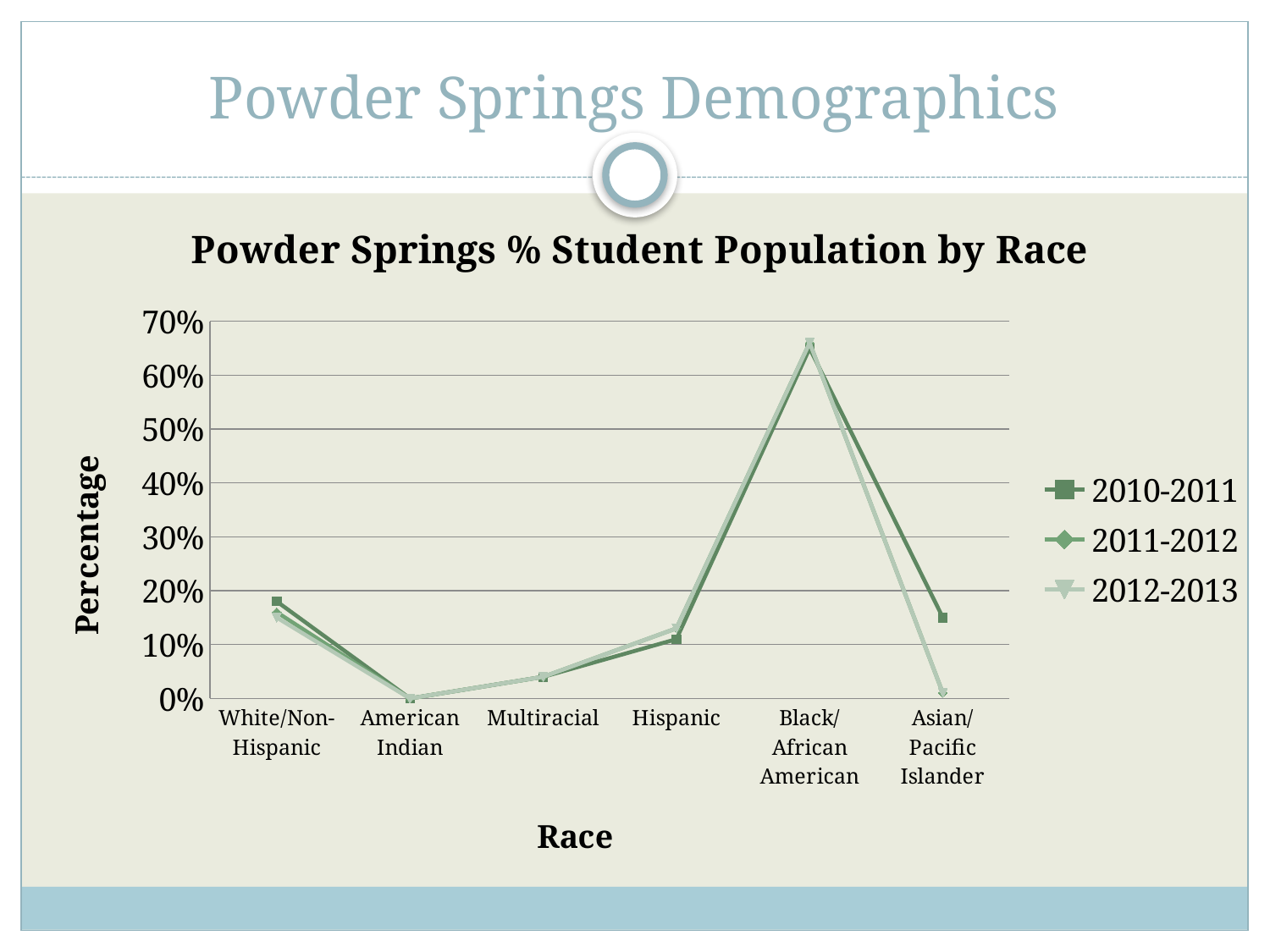
Is the value for White/Non-Hispanic in 2010-2011 greater or less than 20%? less For 2010-2011, which is larger: the value for White/Non-Hispanic or the value for Hispanic? White/Non-Hispanic Which race category has the lowest percentage for 2012-2013? American Indian What is the title of the chart? Powder Springs % Student Population by Race How many series does the legend list? 3 Which race category has the highest percentage for 2010-2011? Black/African American Is the value for Black/African American in 2012-2013 greater or less than 60%? greater Is the value for Hispanic in 2012-2013 greater or less than 10%? greater What is the label on the x axis of the chart? Race What kind of chart is shown on the slide? Line chart How many race categories are shown on the x axis? 6